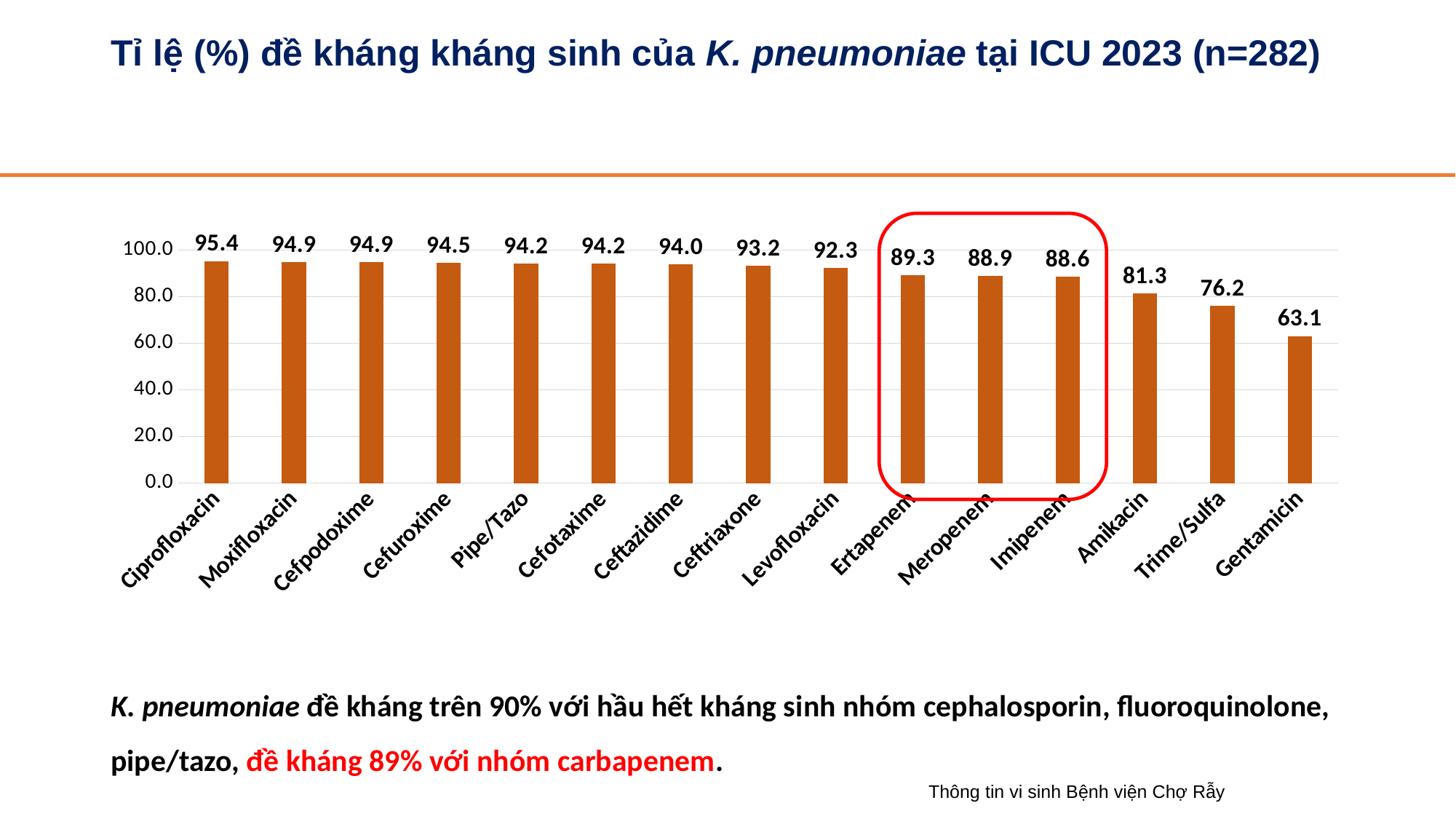
What is the resistance rate for Ciprofloxacin? 95.4 What is the resistance rate for Amikacin? 81.3 What is the difference between the resistance rates for Ertapenem and Imipenem? 0.7 Which antibiotic has the highest resistance rate? Ciprofloxacin What is the resistance rate for Meropenem? 88.9 What is the difference between the resistance rates for Ciprofloxacin and Gentamicin? 32.3 How many antibiotics are shown on the chart? 15 Which antibiotic has the lowest resistance rate? Gentamicin Which has a higher resistance rate, Amikacin or Trime/Sulfa? Amikacin What kind of chart is shown on the slide? Bar chart What is the resistance rate for Gentamicin? 63.1 Which three antibiotics are enclosed by the red outline on the chart? Ertapenem, Meropenem, Imipenem